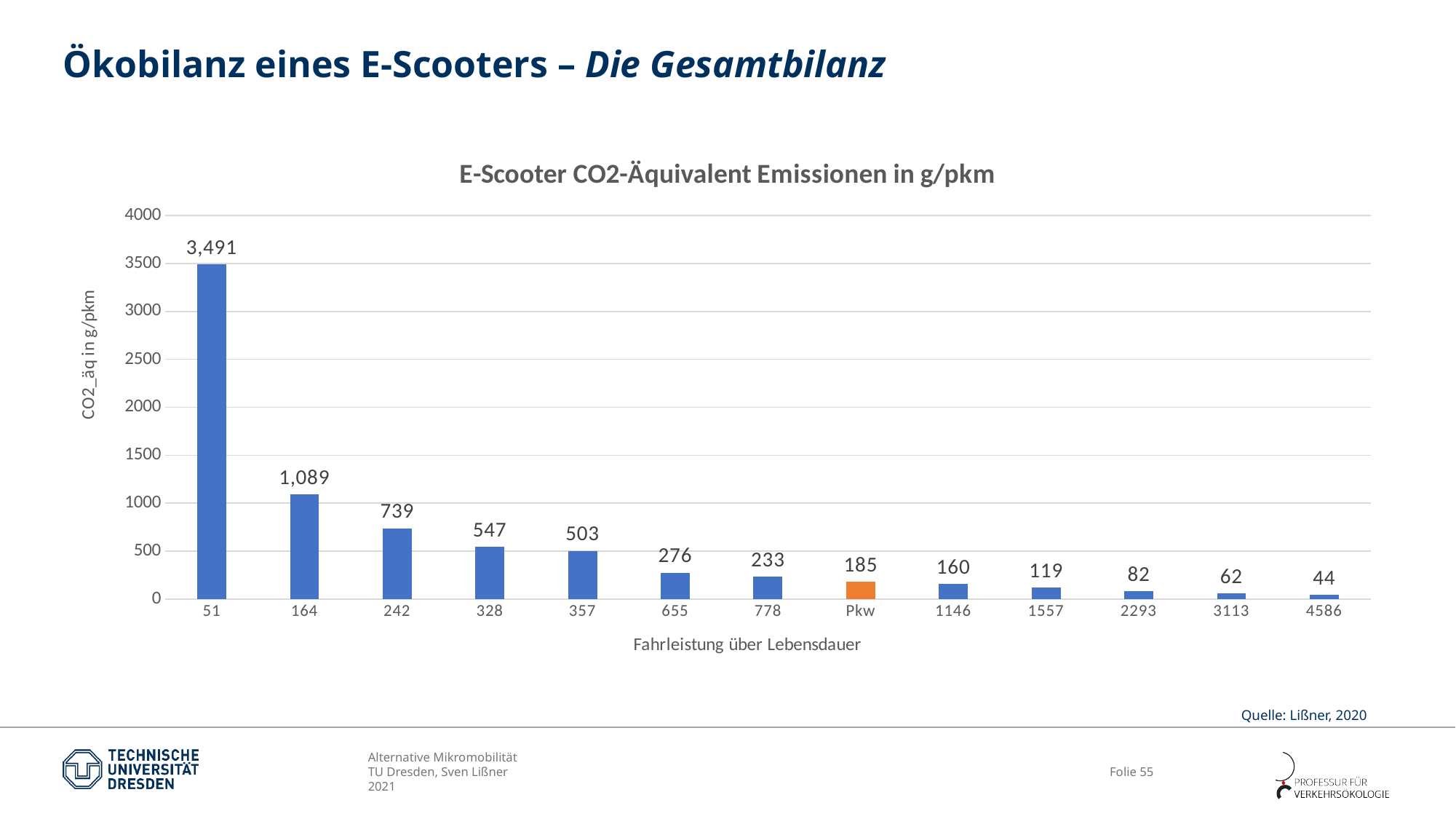
Which is larger, the value for 778 or the value for Pkw? 778 What is the CO2-equivalent emission value for the category 51? 3,491 What kind of chart is shown on the slide? Bar chart How many bars are shown in the chart? 13 Which category has the highest value? 51 Which bar is coloured orange instead of blue? Pkw Do the values generally rise or fall from left to right along the x axis? Fall What is the value for the category 4586? 44 Is the value for 328 greater or less than 500? greater What is the value shown for the Pkw bar? 185 Which category has the lowest value? 4586 What is the difference between the values for 164 and 242? 350